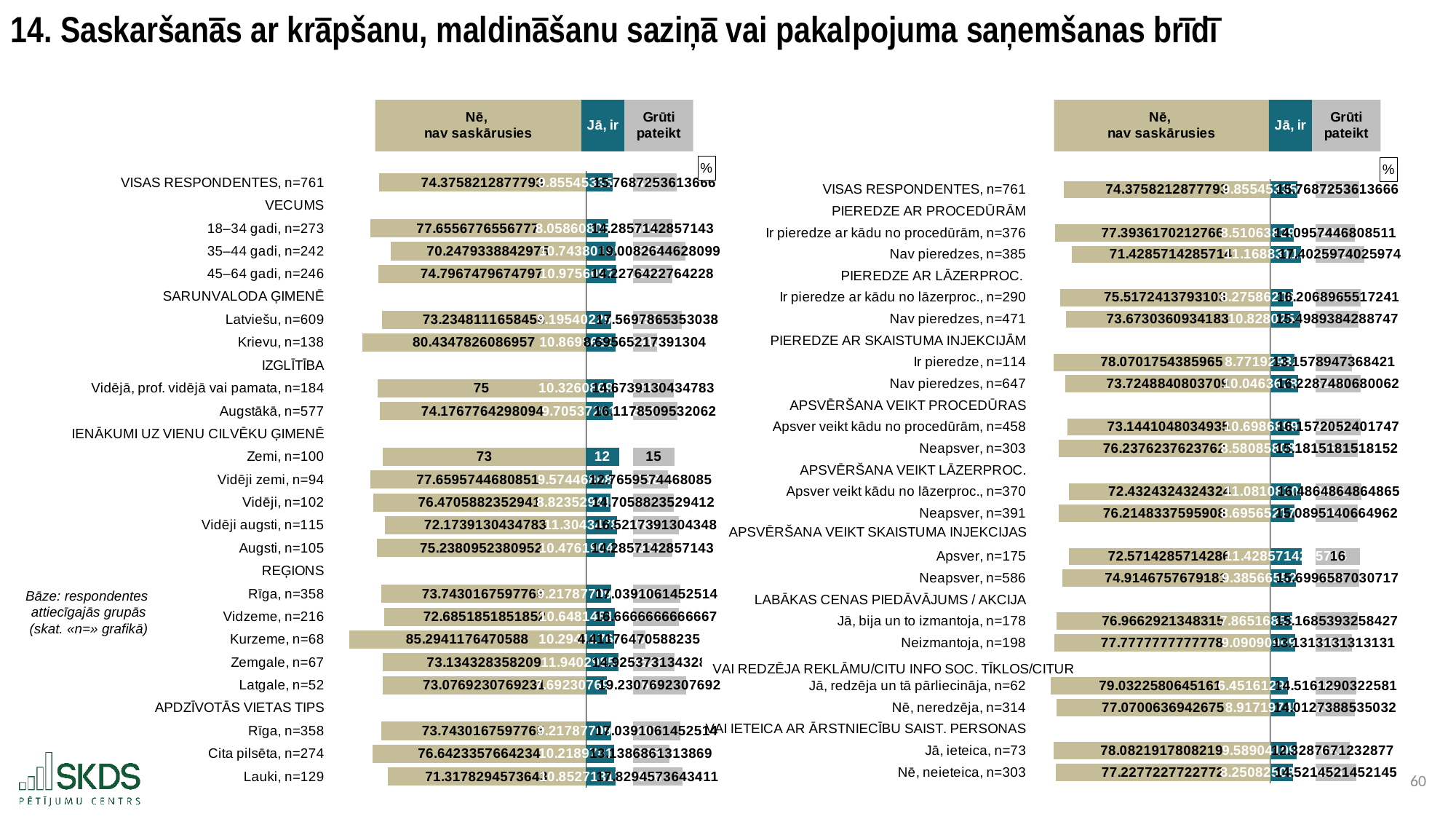
In the left chart, what is the value of 'Nē, nav saskārusies' for 'Vidējā, prof. vidējā vai pamata, n=184'? 75 In the left chart, what is the value of 'Jā, ir' for 'Zemi, n=100'? 12 In the left chart, which has the larger 'Nē, nav saskārusies' value: 'Krievu, n=138' or 'Latviešu, n=609'? Krievu, n=138 In the left chart, what is the value of 'Grūti pateikt' for 'Zemi, n=100'? 15 How many series does the legend of the left chart list? 3 In the right chart, what is the value of 'Grūti pateikt' for 'Apsver, n=175'? 16 In the right chart, what is the value of 'Nē, nav saskārusies' for 'Jā, redzēja un tā pārliecināja, n=62'? 79.0322580645161 In the left chart, what is the value of 'Nē, nav saskārusies' for 'Kurzeme, n=68'? 85.2941176470588 In the left chart, which category has the highest value for 'Nē, nav saskārusies'? Kurzeme, n=68 What kind of chart is used on this slide? Stacked bar chart In the left chart, what is the difference between 'Grūti pateikt' and 'Jā, ir' for 'Zemi, n=100'? 3 In the left chart, what is the total of the stacked bar for 'Zemi, n=100'? 100